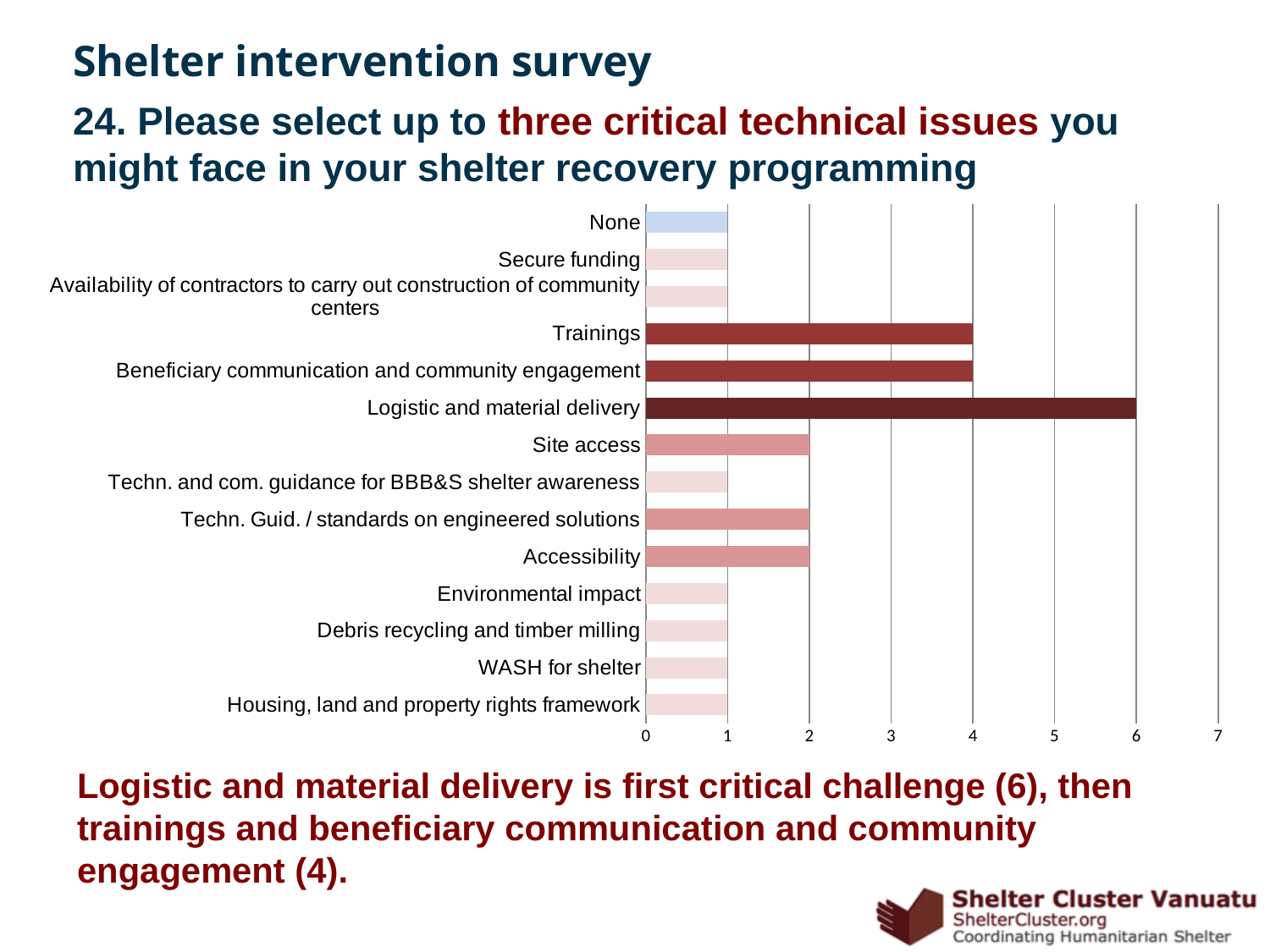
Which category has the highest value? Logistic and material delivery What is the difference between the values for Logistic and material delivery and Trainings? 2 What is the difference between the values for Beneficiary communication and community engagement and Site access? 2 What kind of chart is shown on the slide? bar chart What is the value for Logistic and material delivery? 6 Which is larger, the value for Site access or the value for WASH for shelter? Site access What is the value for Trainings? 4 What is the value for Accessibility? 2 What is the highest value shown on the x axis? 7 What is the value for Site access? 2 Is the value for Logistic and material delivery greater or less than 5? greater How many categories are shown on the chart? 14